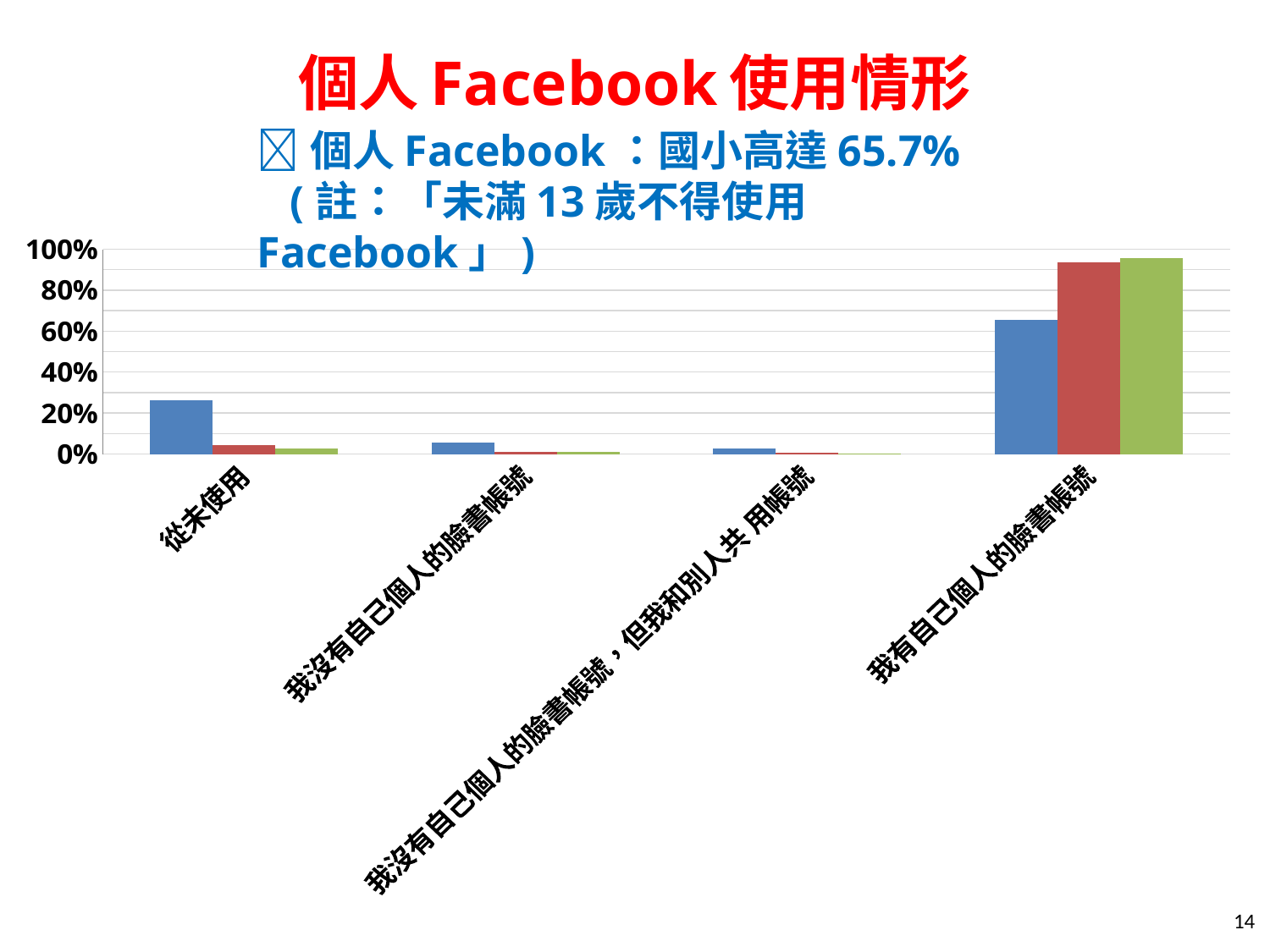
What is the title of the slide containing the chart? 個人 Facebook 使用情形 What kind of chart is shown on the slide? bar chart For the category 從未使用, which bar is taller: the blue bar or the red bar? the blue bar Is the blue bar for 從未使用 greater or less than 20%? greater Is the green bar for 從未使用 greater or less than 20%? less What is the highest tick value shown on the chart's y axis? 100% Is the blue bar for 我有自己個人的臉書帳號 greater or less than 80%? less Which category has the tallest bars in the chart? 我有自己個人的臉書帳號 Which category has the lowest values overall in the chart? 我沒有自己個人的臉書帳號，但我和別人共用帳號 How many categories are shown along the x axis of the chart? 4 How many bars are plotted for each category in the chart? 3